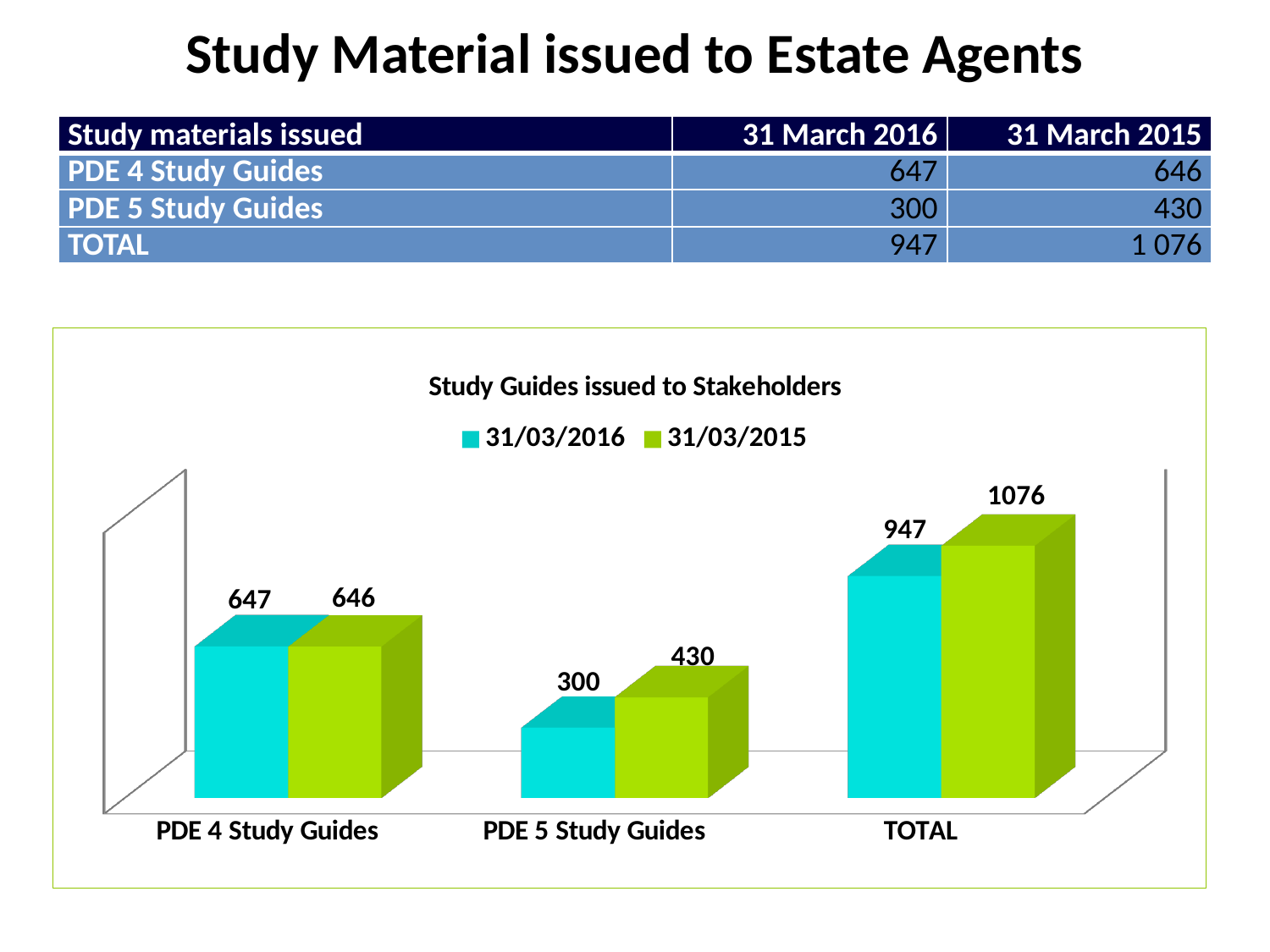
For PDE 5 Study Guides, which series has the larger value, 31/03/2016 or 31/03/2015? 31/03/2015 What is the difference between the 31/03/2015 and 31/03/2016 values for TOTAL? 129 What is the value for PDE 4 Study Guides in the 31/03/2016 series? 647 Which category has the highest value in the 31/03/2015 series? TOTAL What is the value for TOTAL in the 31/03/2015 series? 1076 How many series does the chart legend list? 2 How many categories are shown on the x axis of the chart? 3 What is the value for PDE 5 Study Guides in the 31/03/2015 series? 430 What is the value for TOTAL in the 31/03/2016 series? 947 What is the difference between the 31/03/2015 and 31/03/2016 values for PDE 5 Study Guides? 130 What type of chart is shown on the slide? Bar chart Which category has the lowest value in the 31/03/2016 series? PDE 5 Study Guides